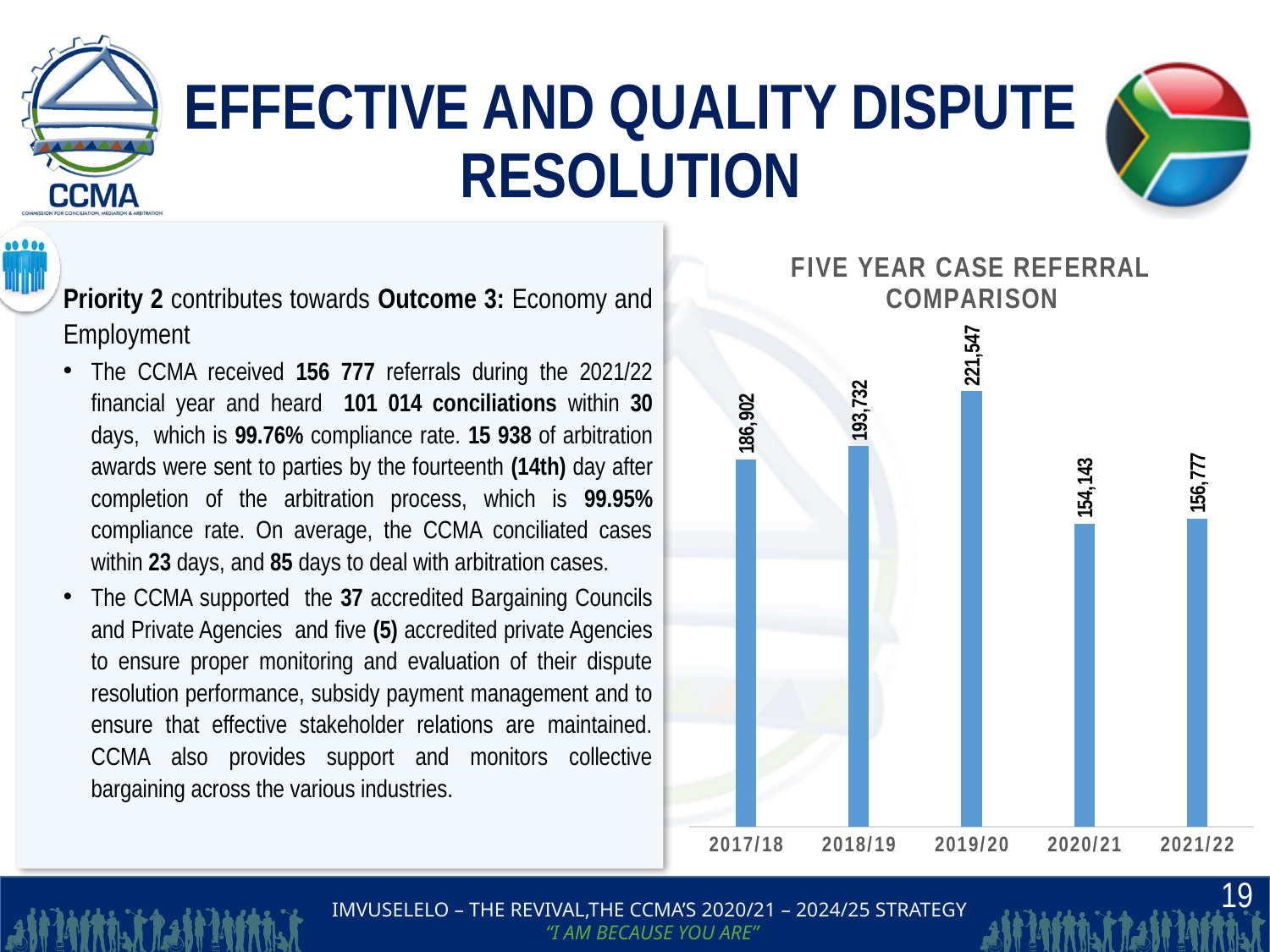
Which year had more case referrals, 2018/19 or 2021/22? 2018/19 What is the case referral value for 2017/18? 186,902 What is the difference in case referrals between 2018/19 and 2017/18? 6,830 What is the case referral value for 2021/22? 156,777 What is the case referral value for 2019/20? 221,547 What type of chart is used to show the five year case referral comparison? Bar chart What is the title of the chart? FIVE YEAR CASE REFERRAL COMPARISON What is the difference in case referrals between 2019/20 and 2020/21? 67,404 How many years are shown on the chart? 5 Do case referrals rise or fall from 2019/20 to 2020/21? Fall Which year has the lowest number of case referrals? 2020/21 Which year has the highest number of case referrals? 2019/20